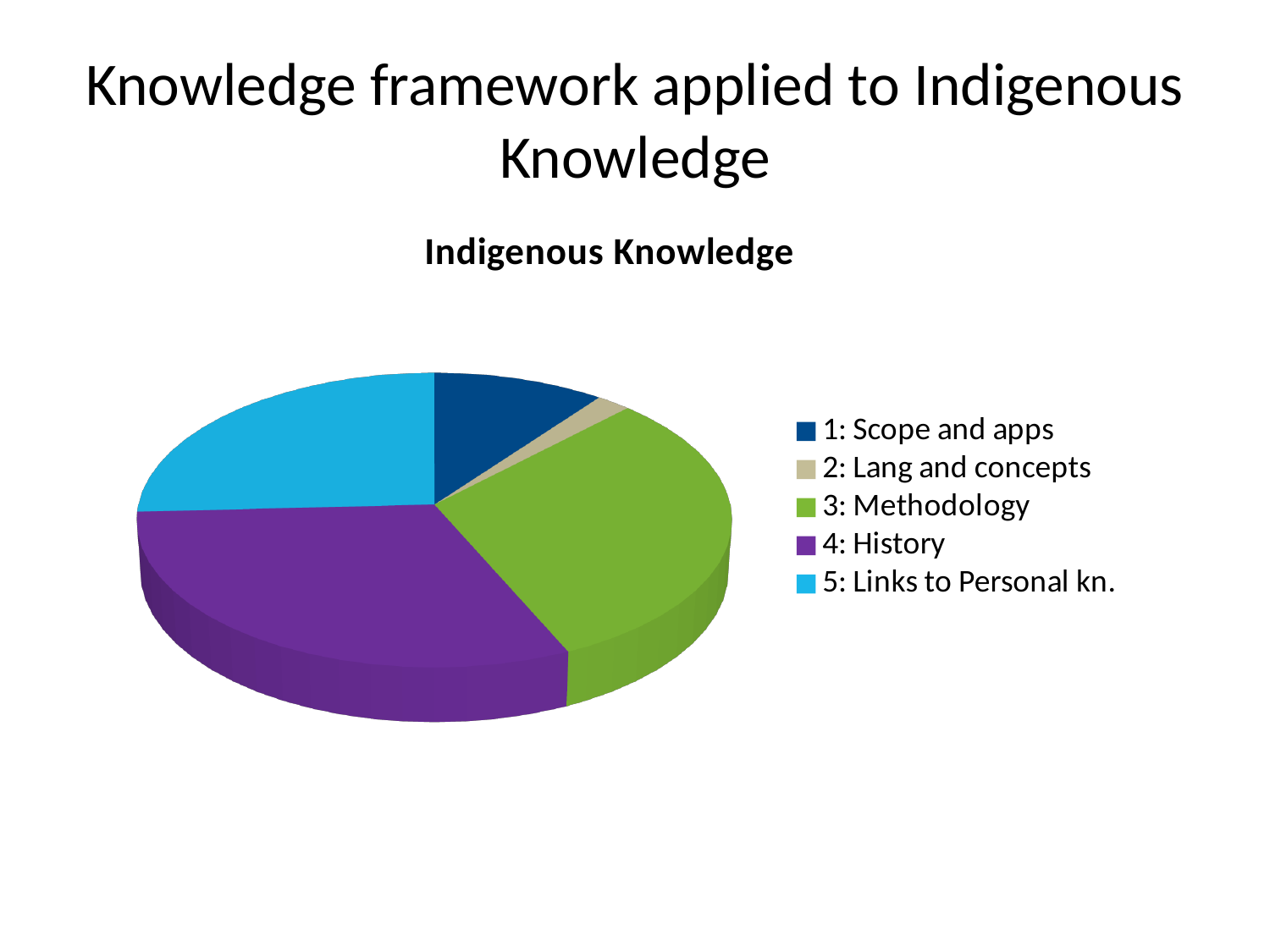
Which slice is larger, 3: Methodology or 5: Links to Personal kn.? 3: Methodology Which category has the smallest slice of the pie? 2: Lang and concepts What kind of chart is shown on the slide? pie chart How many slices does the pie chart have? 5 Which slice is larger, 3: Methodology or 1: Scope and apps? 3: Methodology Which slice is larger, 5: Links to Personal kn. or 2: Lang and concepts? 5: Links to Personal kn. What is the title of the chart? Indigenous Knowledge What colour is the slice for 4: History? purple How many entries does the legend list? 5